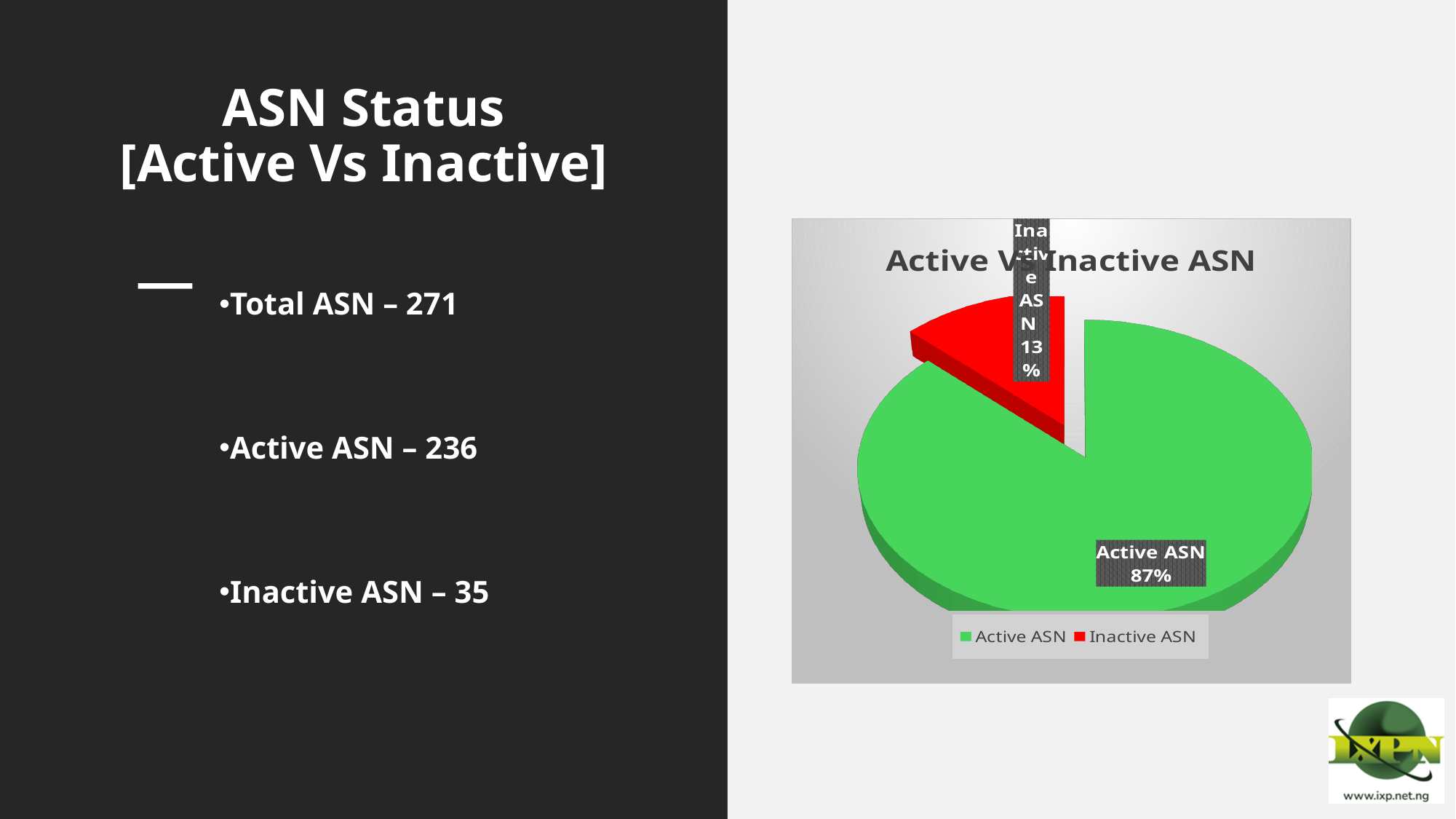
Which slice is the smallest in the pie chart? Inactive ASN What is the title of the chart? Active Vs Inactive ASN What is the difference in percentage points between the Active ASN and Inactive ASN slices? 74 Which slice is the largest in the pie chart? Active ASN Which is larger, the Active ASN slice or the Inactive ASN slice? Active ASN How many series does the chart legend list? 2 What colour represents Inactive ASN in the chart? Red How many slices does the pie chart have? 2 What type of chart is shown on the slide? Pie chart What percentage share does the Active ASN slice have? 87% What percentage share does the Inactive ASN slice have? 13%